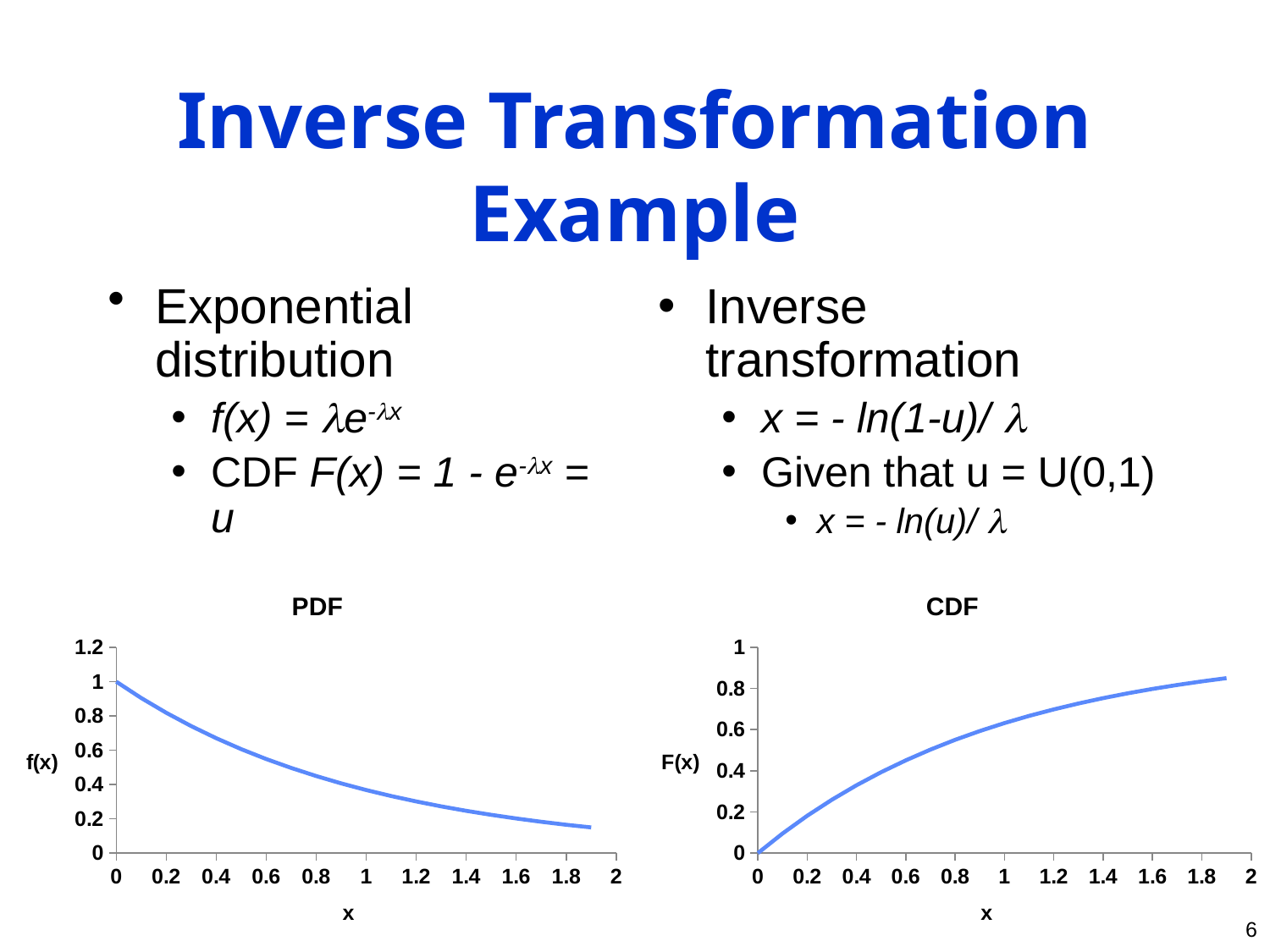
In the PDF chart, do the values rise or fall as x increases? fall In the CDF chart, is the value of F(x) at x = 1.8 greater or less than 0.8? greater In the CDF chart, do the values rise or fall as x increases? rise In the PDF chart, is the value of f(x) at x = 1.8 greater or less than 0.2? less In the CDF chart, is the value of F(x) at x = 0.4 greater or less than 0.4? less What kind of chart is the CDF chart? line chart In the PDF chart, what is the value of f(x) at x = 0? 1 What kind of chart is the PDF chart? line chart In the CDF chart, what is the value of F(x) at x = 0? 0 What is the label on the horizontal axis of the PDF chart? x What is the label on the vertical axis of the CDF chart? F(x)